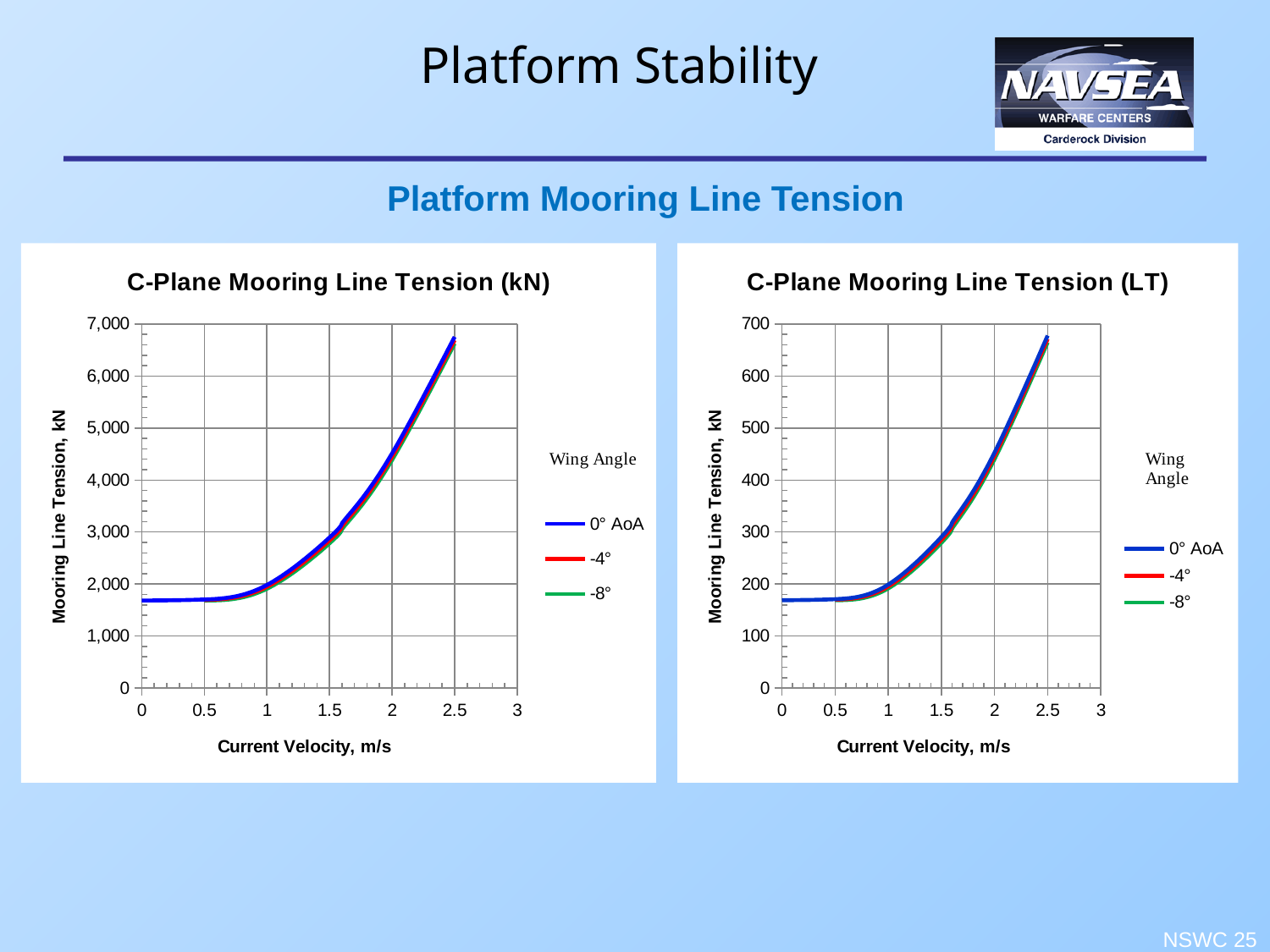
In the right chart, 'C-Plane Mooring Line Tension (LT)', is the value for 0° AoA at a current velocity of 0 m/s greater or less than 200? less What kind of chart is the left chart, 'C-Plane Mooring Line Tension (kN)'? line chart In the left chart, 'C-Plane Mooring Line Tension (kN)', is the value for 0° AoA at a current velocity of 0 m/s greater or less than 2,000? less In the left chart, 'C-Plane Mooring Line Tension (kN)', does the mooring line tension rise or fall as current velocity increases? rise In the right chart, 'C-Plane Mooring Line Tension (LT)', is the value for 0° AoA at a current velocity of 2.5 m/s greater or less than 600? greater How many series does the legend of the left chart, 'C-Plane Mooring Line Tension (kN)', list? 3 How many series does the legend of the right chart, 'C-Plane Mooring Line Tension (LT)', list? 3 What kind of chart is the right chart, 'C-Plane Mooring Line Tension (LT)'? line chart In the right chart, 'C-Plane Mooring Line Tension (LT)', does the mooring line tension rise or fall as current velocity increases? rise In the left chart, 'C-Plane Mooring Line Tension (kN)', what colour is the line for the -8° wing angle series? green